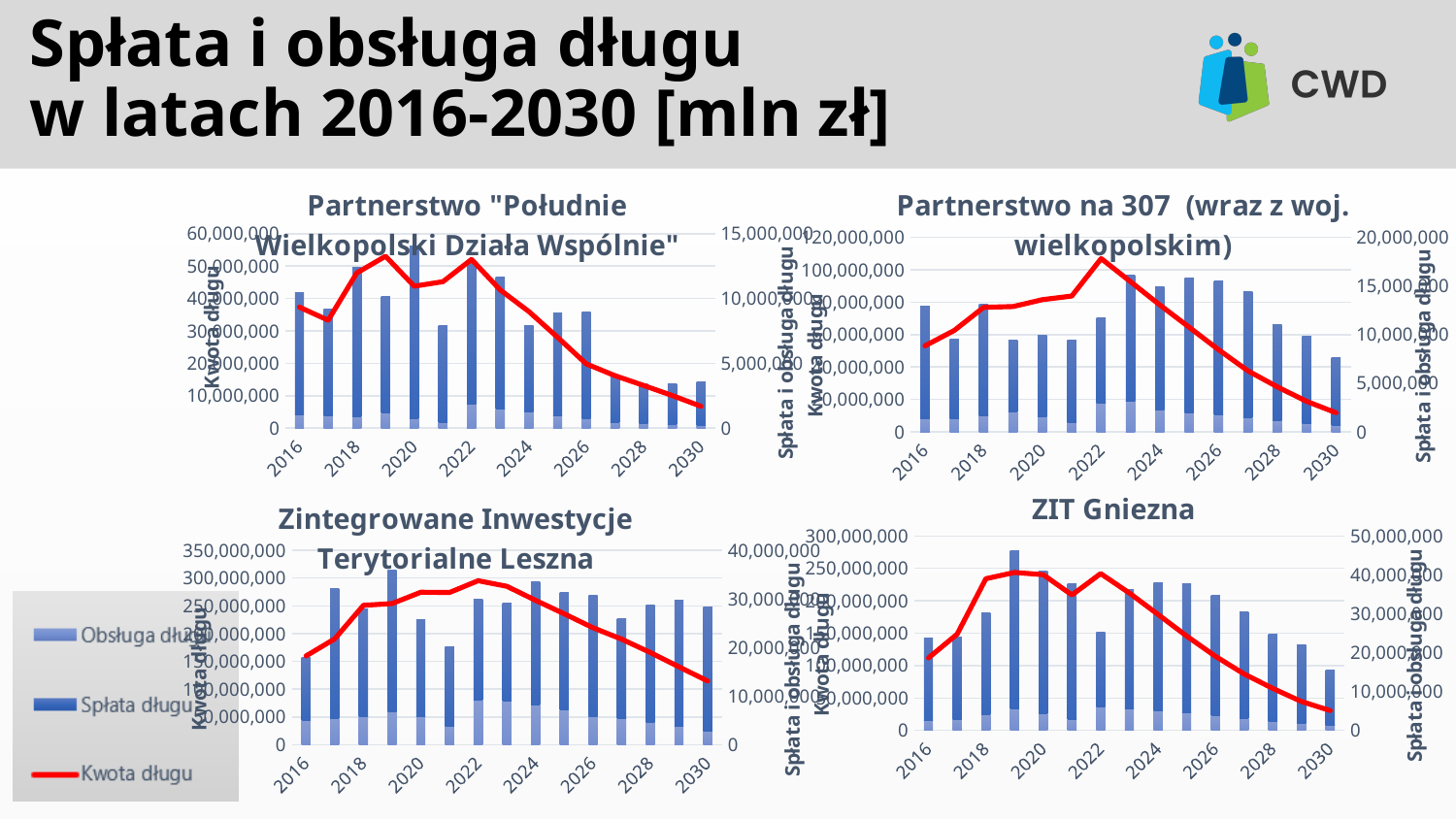
How many series does the legend on the slide list? 3 In the "Partnerstwo "Południe Wielkopolski Działa Wspólnie"" chart, which year has the tallest bar? 2020 What kind of chart is the "ZIT Gniezna" chart? Bar and line chart In the "Zintegrowane Inwestycje Terytorialne Leszna" chart, which year has the shortest bar? 2016 What are the three series named in the legend? Obsługa długu, Spłata długu, Kwota długu In the "ZIT Gniezna" chart, which year has the tallest bar? 2019 How many years are shown on the x axis of the "Zintegrowane Inwestycje Terytorialne Leszna" chart? 15 In the "Zintegrowane Inwestycje Terytorialne Leszna" chart, which year has the tallest bar? 2019 In the "Partnerstwo na 307 (wraz z woj. wielkopolskim)" chart, does the Kwota długu line rise or fall from 2022 to 2030? fall